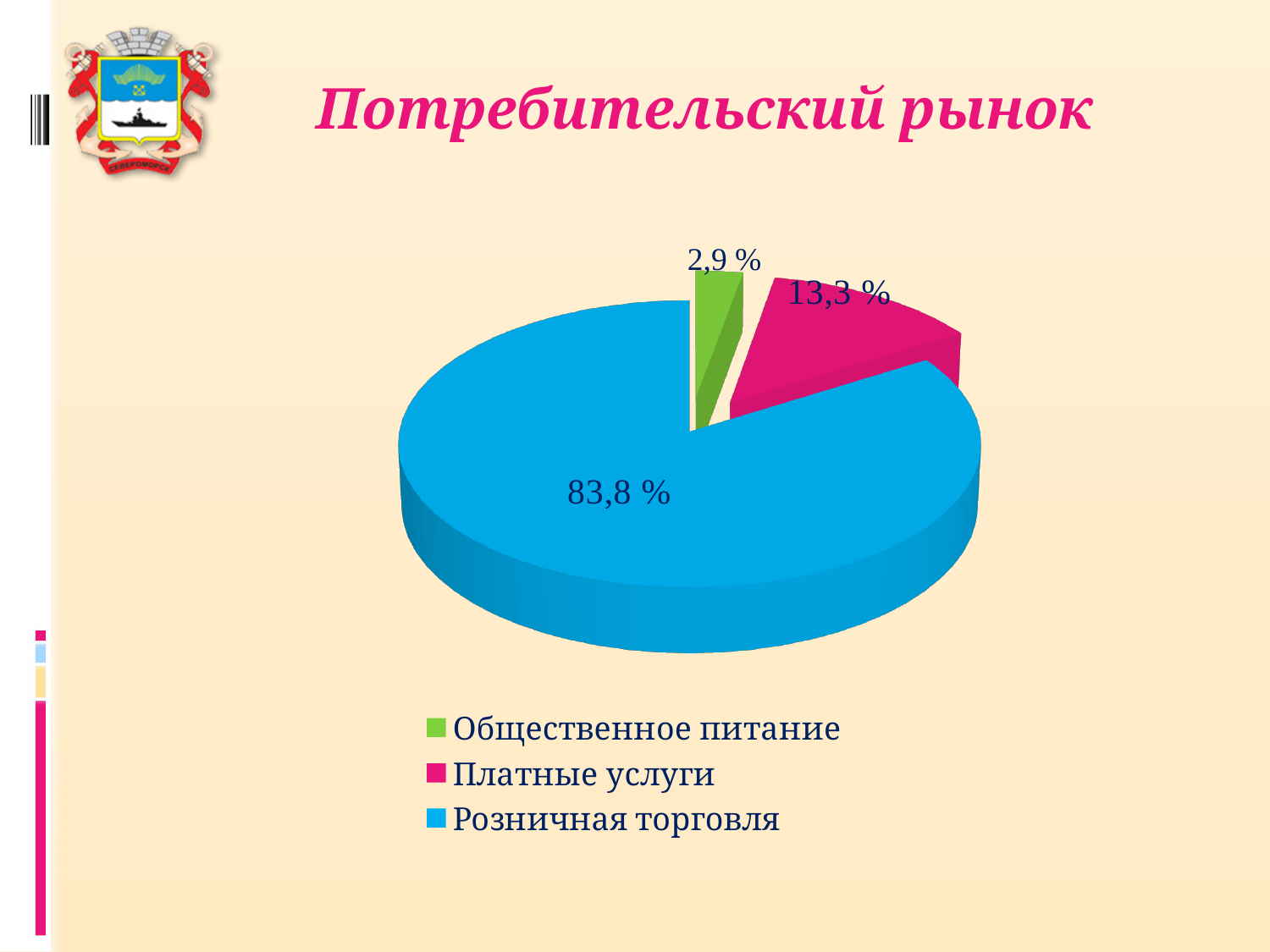
What is the difference between the values for Платные услуги and Общественное питание? 10,4 % Which is larger, Платные услуги or Общественное питание? Платные услуги What colour is the slice for Платные услуги? Pink How many categories does the pie chart show? 3 What kind of chart is shown on the slide? Pie chart What share of the pie does Розничная торговля have? 83,8 % What is the value shown for Общественное питание? 2,9 % Which category has the smallest slice of the pie? Общественное питание What is the title of the slide? Потребительский рынок What is the difference between the values for Розничная торговля and Платные услуги? 70,5 % Which category has the largest slice of the pie? Розничная торговля What is the value shown for Платные услуги? 13,3 %